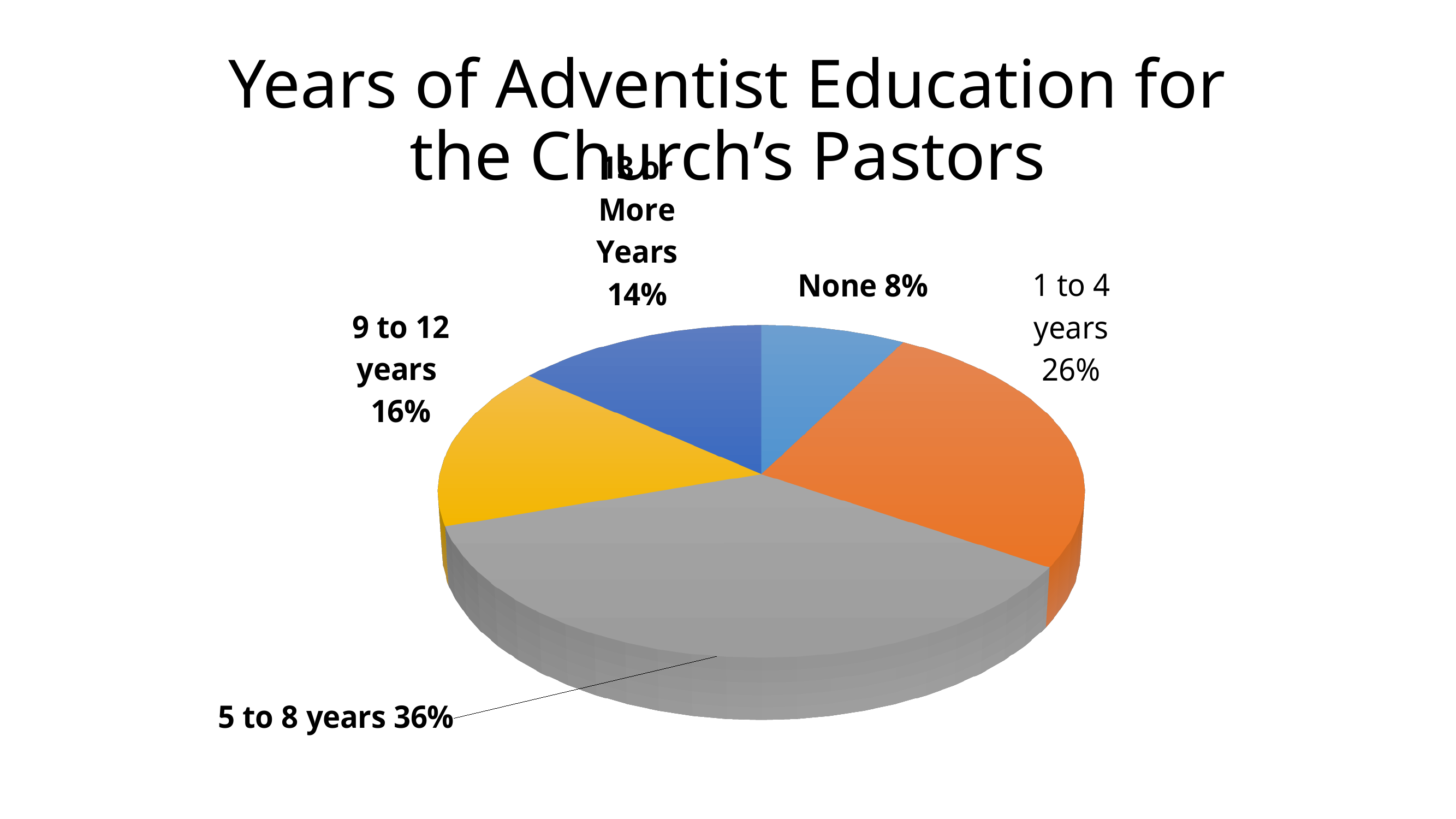
What kind of chart is shown on the slide? pie chart What is the title of the chart? Years of Adventist Education for the Church's Pastors What percentage of pastors had no Adventist education (None)? 8% How many slices does the pie chart have? 5 What colour is the 5 to 8 years slice? grey What percentage of pastors had 9 to 12 years of Adventist education? 16% Which category has the largest share of the pie? 5 to 8 years What is the difference in percentage points between the 5 to 8 years slice and the 1 to 4 years slice? 10 What percentage of pastors had 5 to 8 years of Adventist education? 36% Which category has the smallest share of the pie? None Which is larger, the share for 9 to 12 years or the share for 1 to 4 years? 1 to 4 years What percentage of pastors had 1 to 4 years of Adventist education? 26%